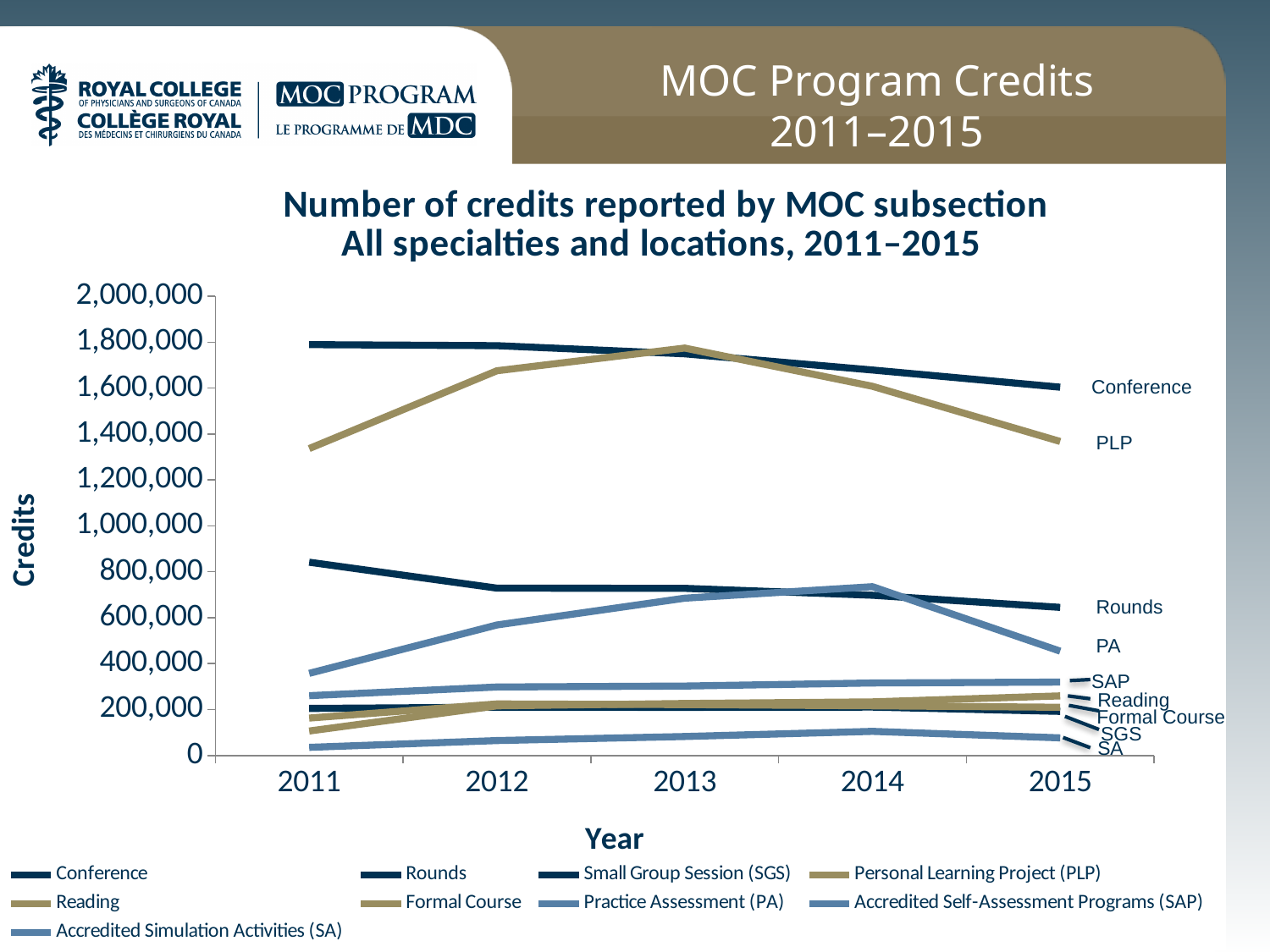
Which MOC subsection had the lowest number of credits in 2011? Accredited Simulation Activities (SA) How many series does the legend list? 9 Which MOC subsection had the highest number of credits in 2011? Conference In 2011, which had more credits: Conference or Personal Learning Project (PLP)? Conference Is the value for Practice Assessment (PA) in 2015 greater or less than 600,000? less Is the value for Conference in 2011 greater or less than 1,600,000? greater In 2015, which had more credits: Rounds or Practice Assessment (PA)? Rounds What type of chart is shown on the slide? Line chart How many years are shown on the x axis? 5 Do the Conference credits rise or fall from 2011 to 2015? Fall Is the value for Rounds in 2011 greater or less than 1,000,000? less